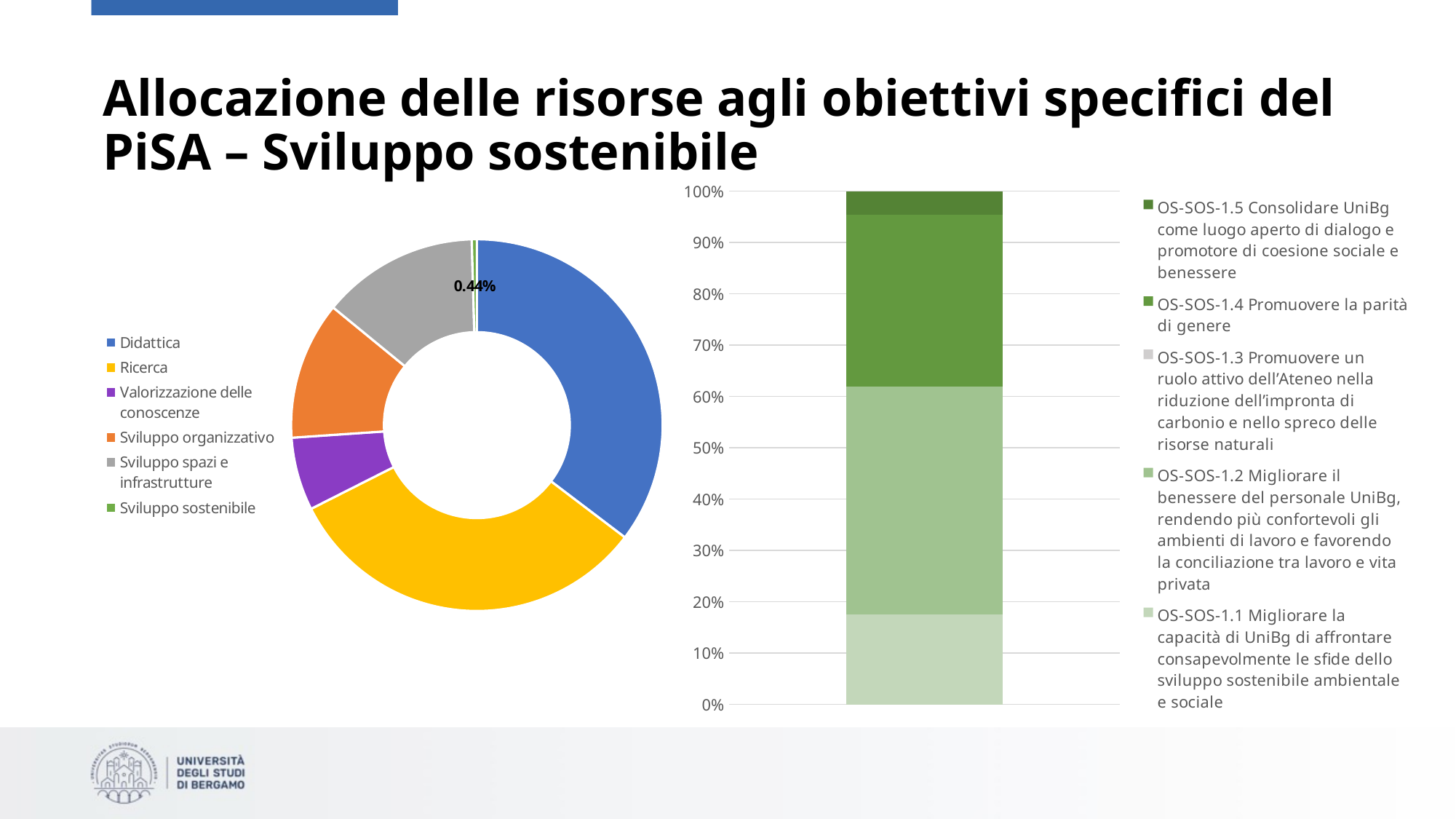
How many categories does the legend of the doughnut chart on the left list? 6 In the stacked bar chart on the right, is the share for OS-SOS-1.2 greater or less than 40%? greater In the doughnut chart on the left, what colour represents Didattica? Blue In the stacked bar chart on the right, which series has the largest segment? OS-SOS-1.2 How many series does the legend of the stacked bar chart on the right list? 5 In the doughnut chart on the left, which category has the smallest slice? Sviluppo sostenibile In the doughnut chart on the left, which category has the largest slice? Didattica What kind of chart is the chart on the left of the slide? Doughnut (pie) chart What kind of chart is the chart on the right of the slide? Stacked bar chart In the doughnut chart on the left, which slice is larger: Sviluppo organizzativo or Valorizzazione delle conoscenze? Sviluppo organizzativo In the doughnut chart on the left, what value is shown for Sviluppo sostenibile? 0.44% In the stacked bar chart on the right, is the share for OS-SOS-1.1 greater or less than 20%? less